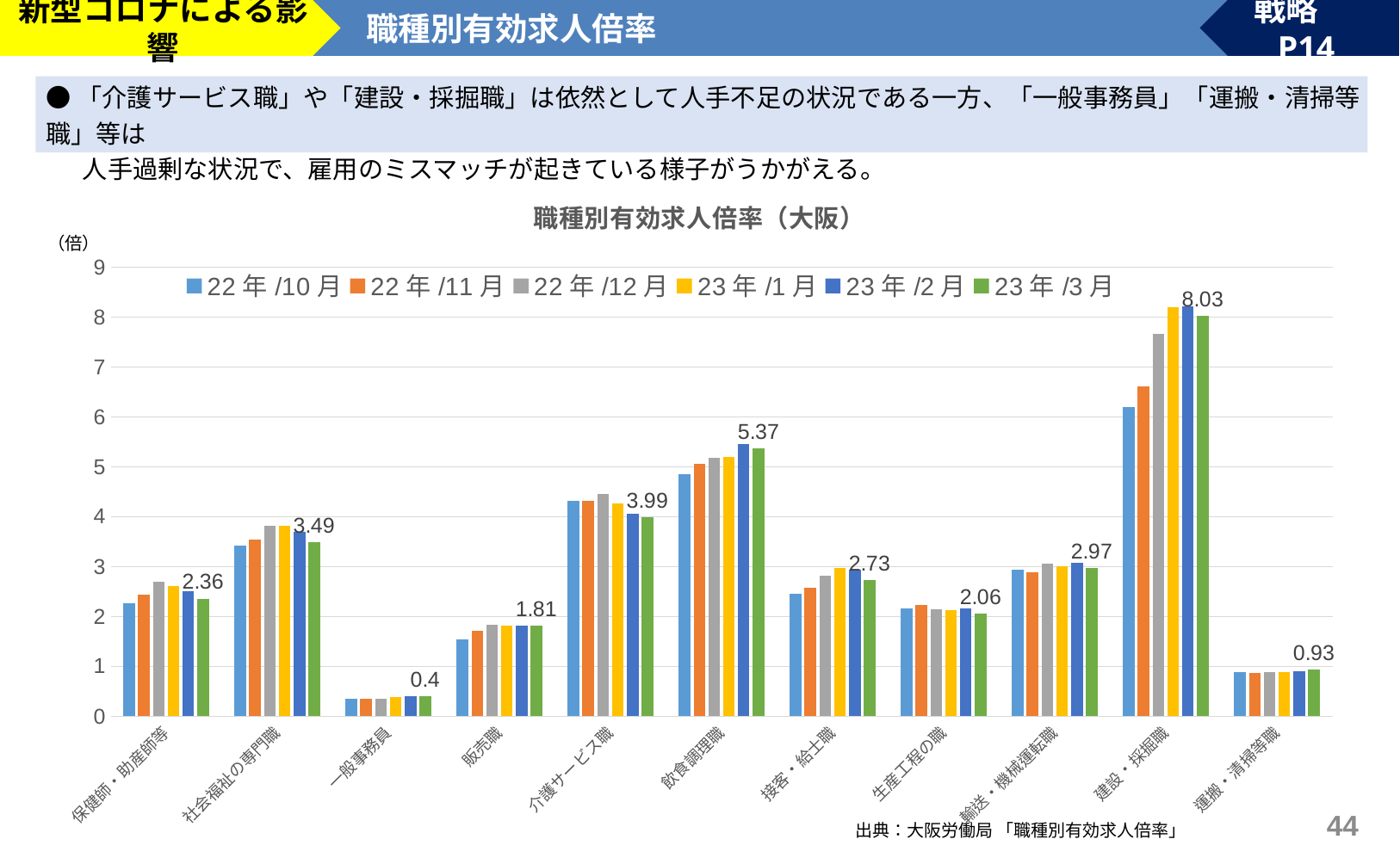
What is the title of the chart? 職種別有効求人倍率（大阪） What is the labelled value for 一般事務員 in 23年/3月? 0.4 How many series does the legend list? 6 What is the difference between the 23年/3月 values for 建設・採掘職 and 運搬・清掃等職? 7.1 What is the labelled value for 介護サービス職 in 23年/3月? 3.99 What is the labelled value for 建設・採掘職 in 23年/3月? 8.03 Which occupation has the highest value in 23年/3月? 建設・採掘職 What kind of chart is shown on the slide? bar chart Which is larger in 23年/3月: 飲食調理職 or 介護サービス職? 飲食調理職 How many occupation categories are shown on the x axis? 11 Is the value for 建設・採掘職 in 22年/10月 greater or less than 6? greater Which occupation has the lowest value in 23年/3月? 一般事務員